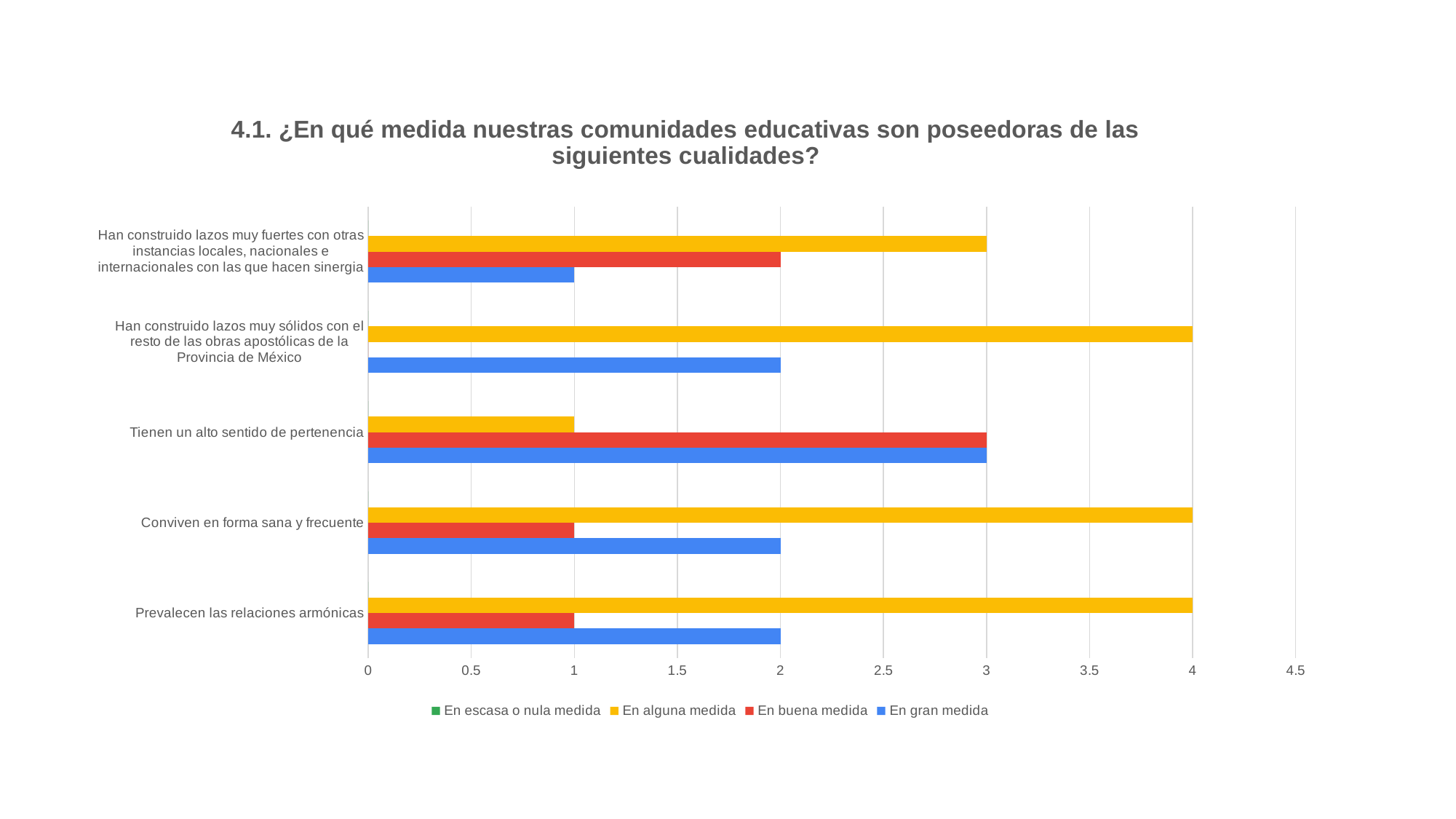
What is the value of 'En buena medida' for 'Tienen un alto sentido de pertenencia'? 3 Which category has the highest value for 'En gran medida'? Tienen un alto sentido de pertenencia For 'Han construido lazos muy sólidos con el resto de las obras apostólicas de la Provincia de México', which is larger: 'En alguna medida' or 'En gran medida'? En alguna medida What is the difference between 'En alguna medida' and 'En gran medida' for 'Prevalecen las relaciones armónicas'? 2 How many series does the legend list? 4 What is the value of 'En alguna medida' for 'Conviven en forma sana y frecuente'? 4 Which category has the lowest value for 'En alguna medida'? Tienen un alto sentido de pertenencia What is the value of 'En gran medida' for 'Han construido lazos muy fuertes con otras instancias locales, nacionales e internacionales con las que hacen sinergia'? 1 How many categories are plotted on the chart? 5 What colour represents 'En buena medida' in the legend? red What kind of chart is shown on the slide? bar chart What is the value of 'En alguna medida' for 'Tienen un alto sentido de pertenencia'? 1